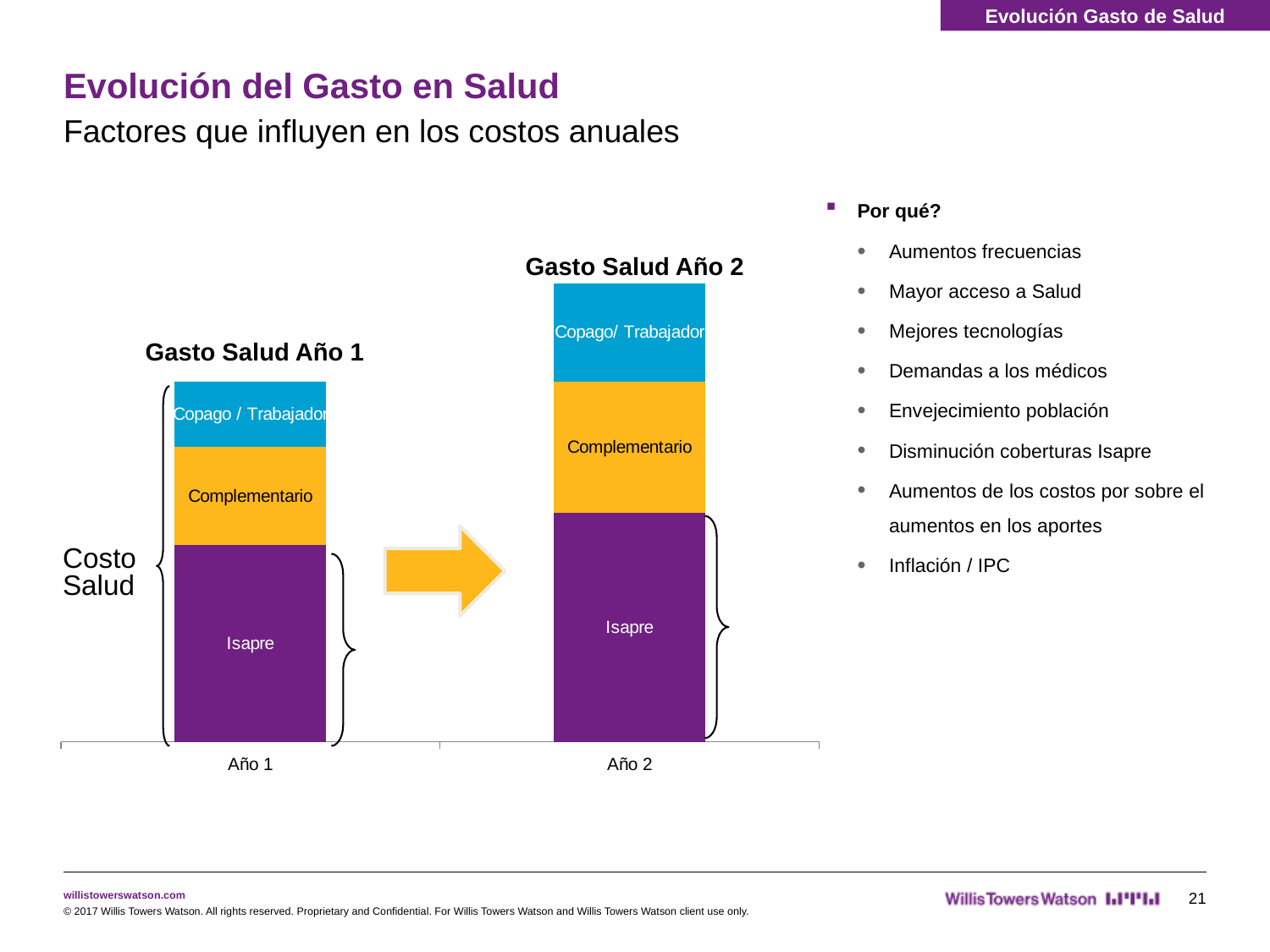
Which bar is taller overall, Año 1 or Año 2? Año 2 How many bars (categories) are plotted on the x axis of the chart? 2 Is the Isapre segment larger in Año 1 or in Año 2? Año 2 Which segment is the largest within the Año 1 bar? Isapre Does the total health cost rise or fall from Año 1 to Año 2 in the chart? Rise What kind of chart is shown on the slide? Stacked bar chart What are the two category labels on the x axis of the chart? Año 1 and Año 2 Which segment is at the bottom of each stacked bar? Isapre What is the title shown above the second bar in the chart? Gasto Salud Año 2 Which segment is shown in blue at the top of each stacked bar? Copago / Trabajador Which segment is the largest within the Año 2 bar? Isapre How many segments make up each stacked bar in the chart? 3